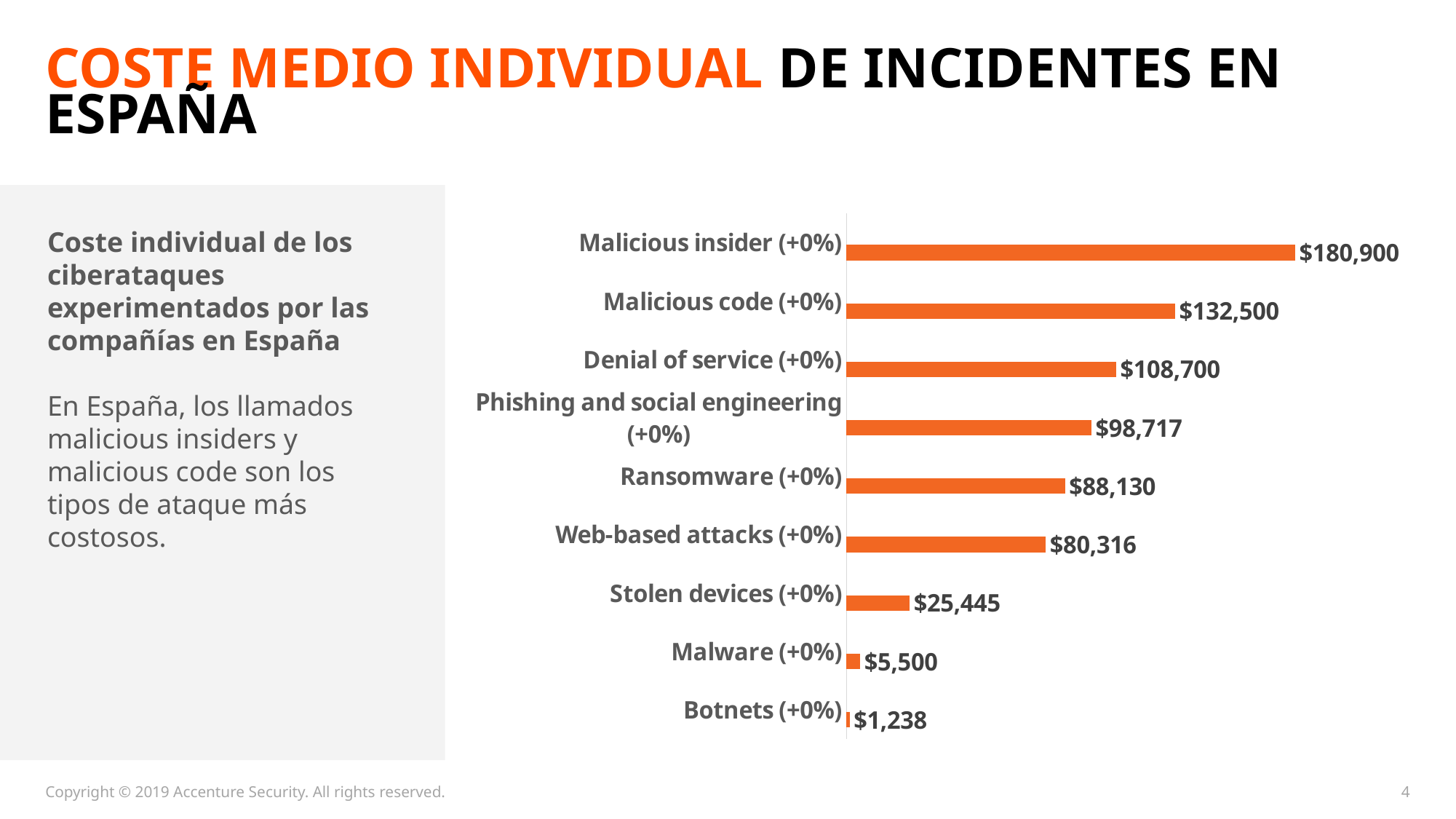
What is the value for Malicious insider (+0%)? $180,900 Which category has the lowest value? Botnets (+0%) Do the bar values increase or decrease from the top category to the bottom category? Decrease What is the value for Stolen devices (+0%)? $25,445 What is the difference between the values for Malicious insider (+0%) and Malicious code (+0%)? $48,400 What is the difference between the values for Stolen devices (+0%) and Malware (+0%)? $19,945 Which category has the highest value? Malicious insider (+0%) How many categories are shown in the chart? 9 What is the value for Botnets (+0%)? $1,238 Which is larger, the value for Denial of service (+0%) or the value for Web-based attacks (+0%)? Denial of service (+0%) What kind of chart is shown on the slide? Bar chart What is the value for Ransomware (+0%)? $88,130